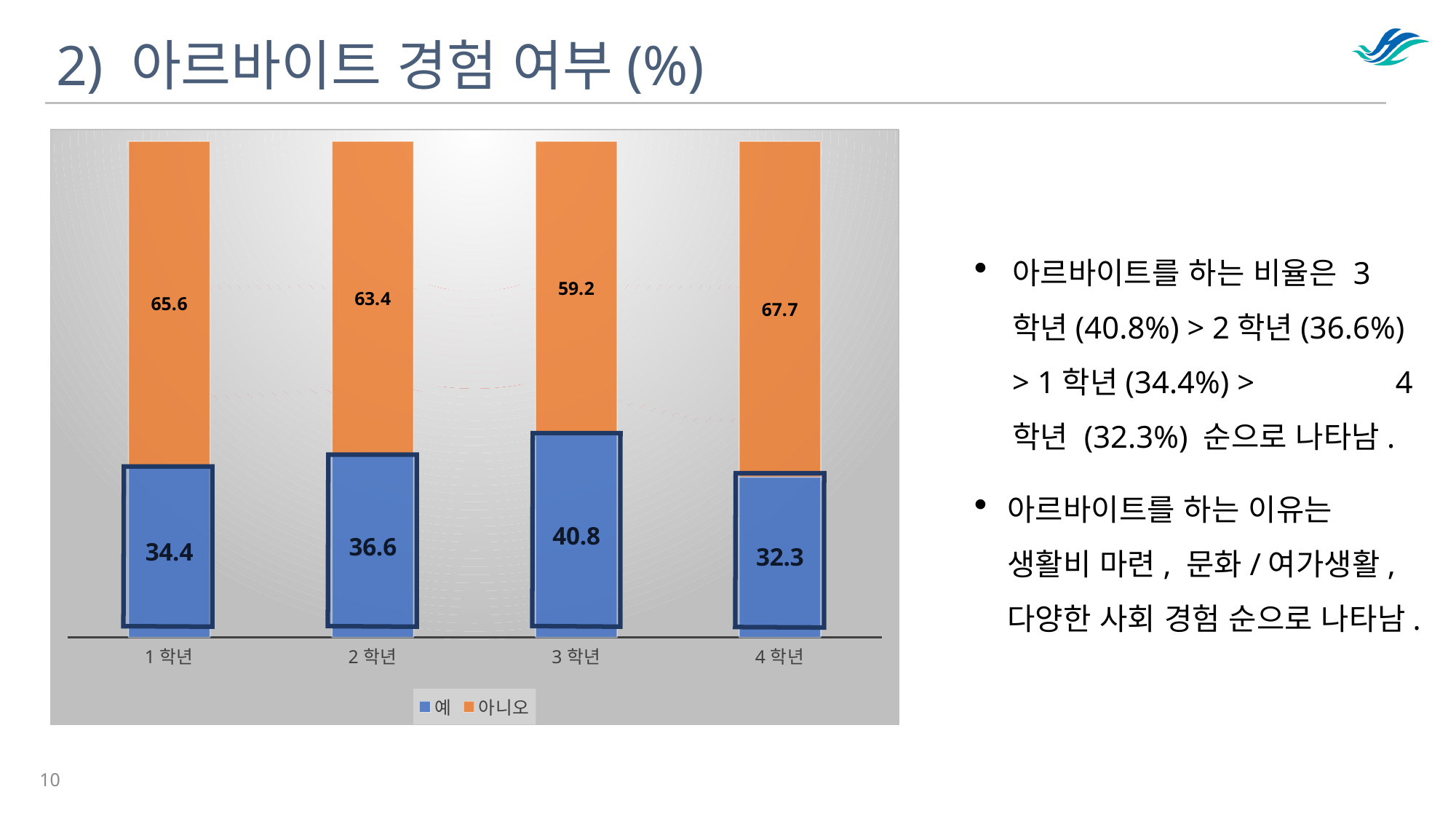
What is the value of 아니오 for 1 학년? 65.6 What is the total of the stacked bar for 4 학년? 100 What is the difference between the 예 values for 3 학년 and 4 학년? 8.5 What is the value of 예 for 3 학년? 40.8 Which grade has the highest value for 예? 3 학년 What is the value of 예 for 4 학년? 32.3 How many series does the legend list? 2 Which is larger, the 예 value for 1 학년 or for 2 학년? 2 학년 What is the value of 아니오 for 2 학년? 63.4 How many grade categories are shown on the x axis? 4 What kind of chart is shown on the slide? Stacked bar chart Which grade has the lowest value for 아니오? 3 학년